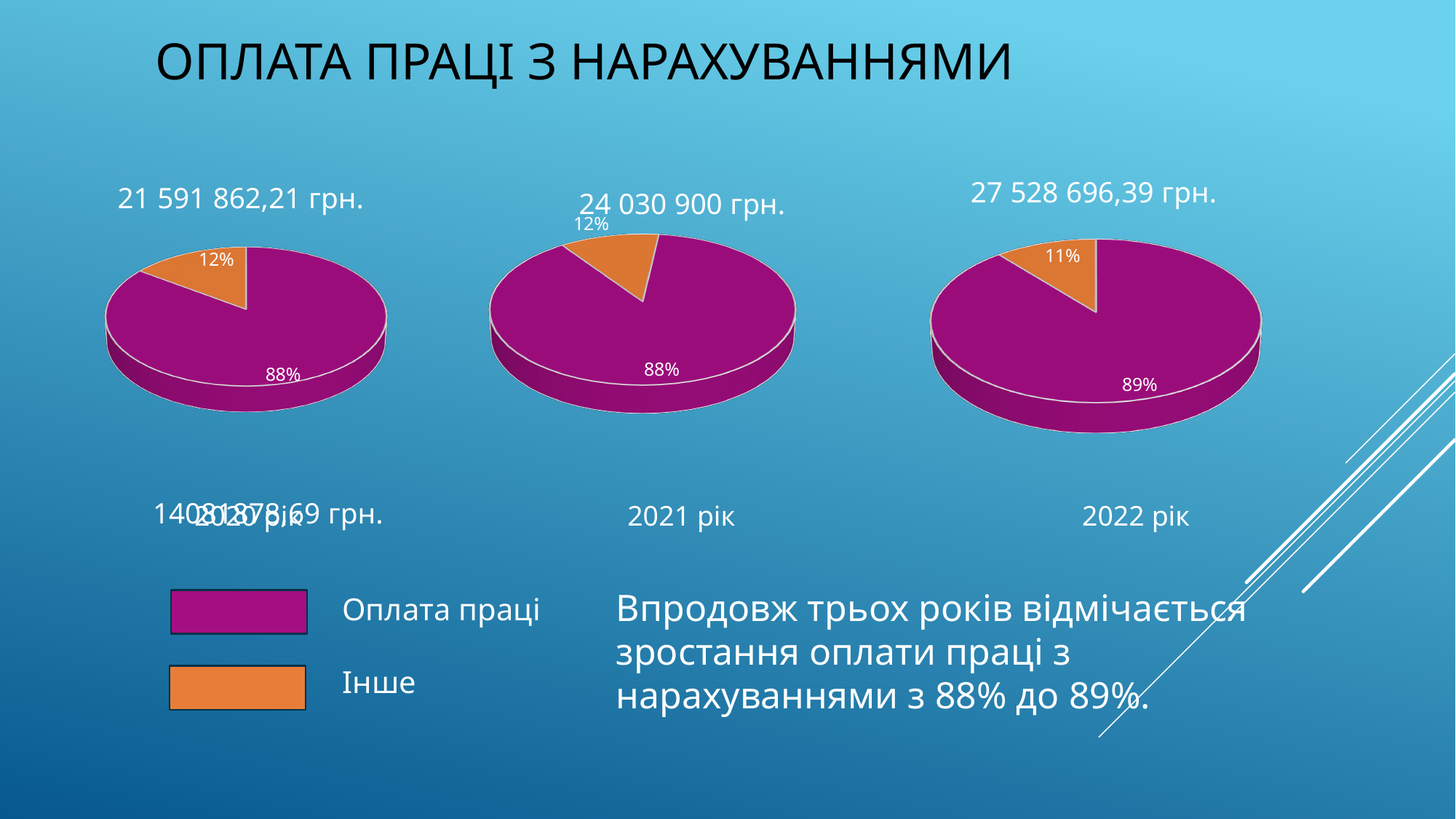
What kind of chart is used for each year on this slide? Pie chart In the pie chart for 2021 рік, what share does the Інше slice have? 12% What is the difference between the Оплата праці share in the 2022 рік pie chart and the Оплата праці share in the 2020 рік pie chart? 1% How many slices does the pie chart for 2021 рік have? 2 In the pie chart for 2022 рік, which slice is the smallest? Інше In the pie chart for 2021 рік, which slice is larger, Оплата праці or Інше? Оплата праці What total amount is printed above the pie chart for 2021 рік? 24 030 900 грн. In the pie chart for 2022 рік, what share does the Оплата праці slice have? 89% In the pie chart for 2020 рік, what share does the Оплата праці slice have? 88% How many entries does the legend on the slide list? 2